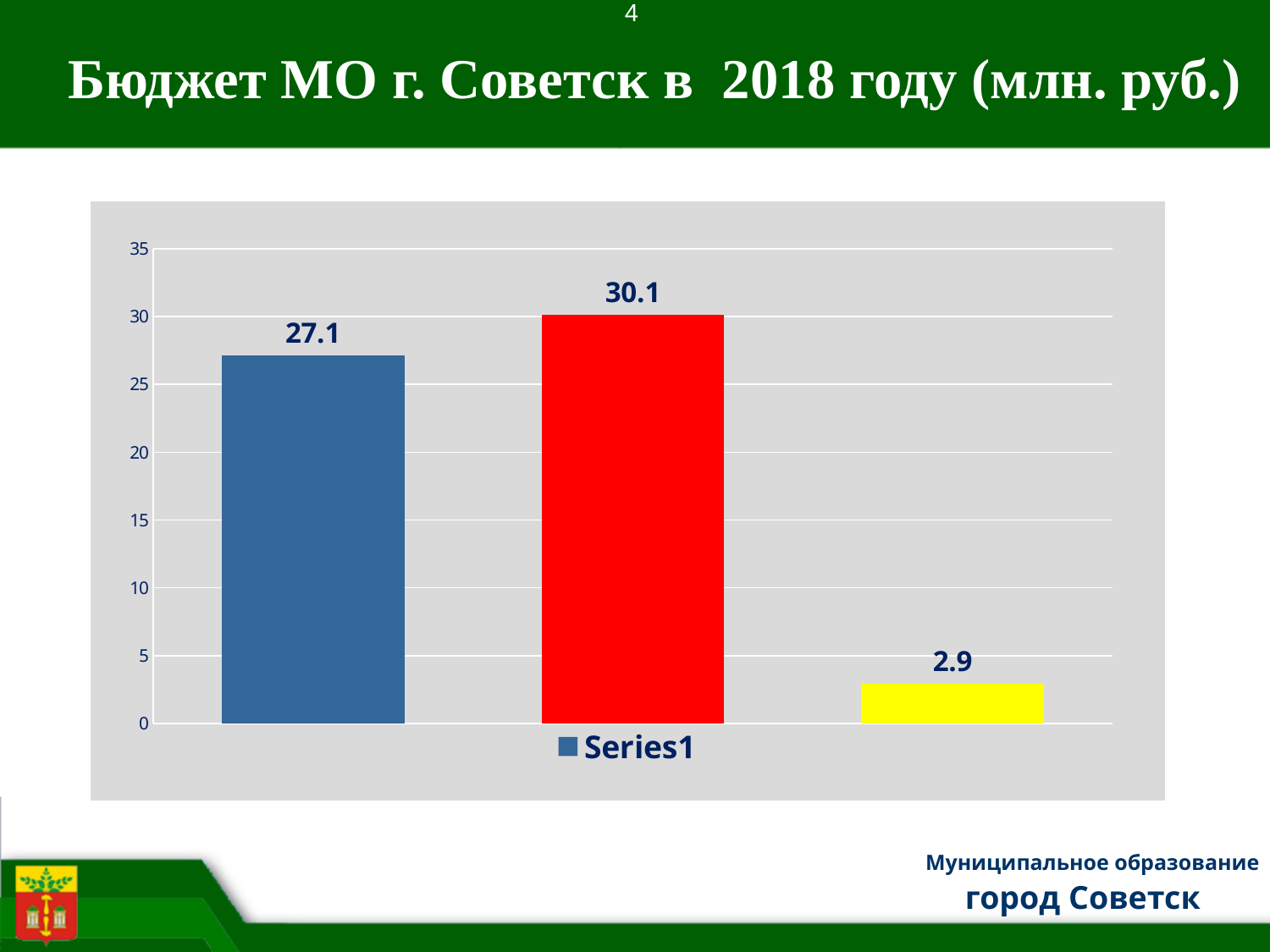
How many series does the legend list? 1 What is the value of the red bar (the middle bar)? 30.1 Which is larger, the value of the blue bar or the value of the red bar? red bar What is the value of the yellow bar (the rightmost bar)? 2.9 What is the value of the blue bar (the first bar from the left)? 27.1 What is the difference between the blue bar's value and the yellow bar's value? 24.2 Is the value of the yellow bar greater or less than 5? less Which bar has the lowest value: the blue, red or yellow one? yellow What kind of chart is shown on the slide? bar chart Which bar has the highest value: the blue, red or yellow one? red How many bars are plotted in the chart? 3 What is the difference between the red bar's value and the blue bar's value? 3.0